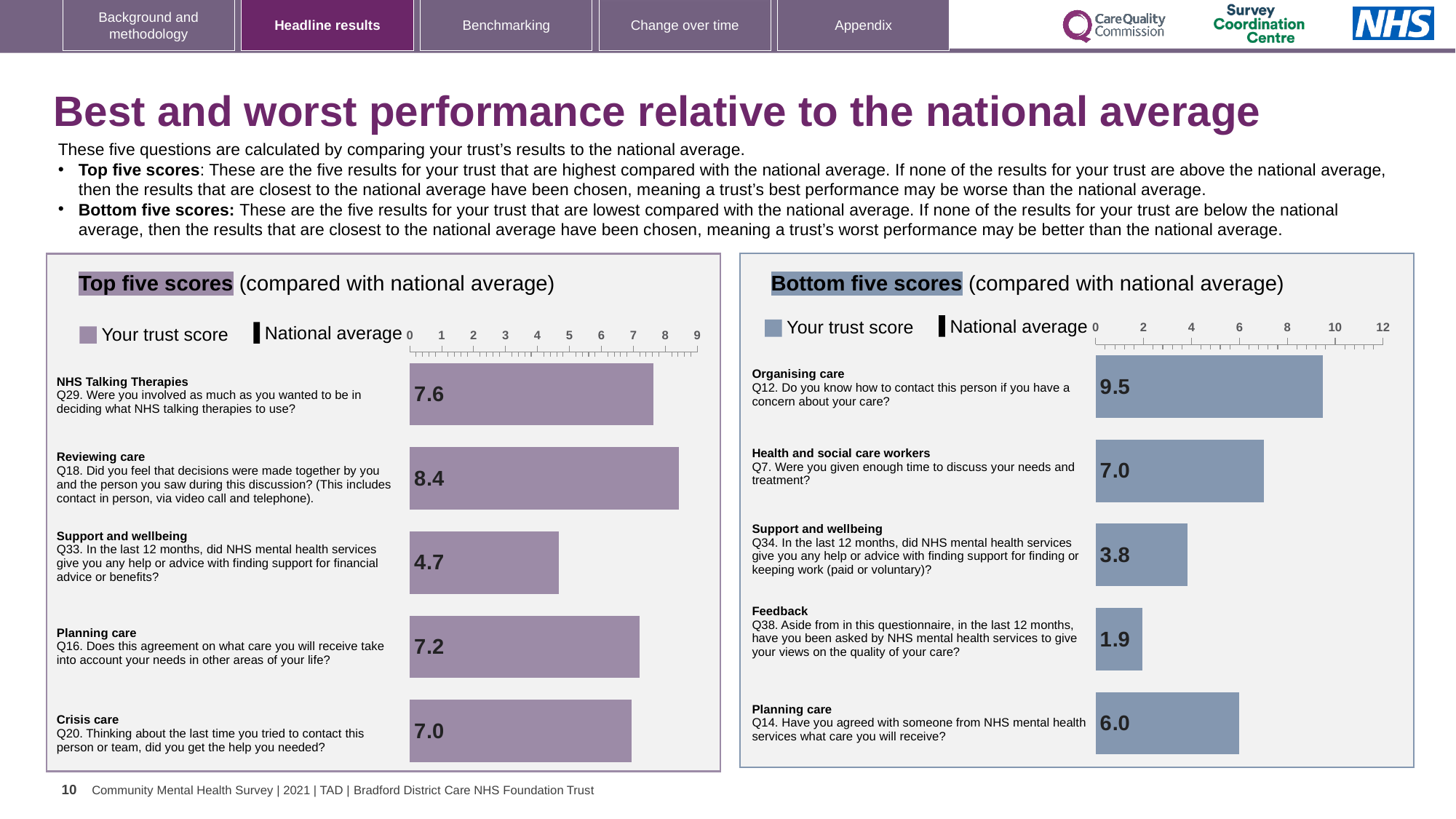
In the Bottom five scores chart, is the trust score for Q7 larger or smaller than the score for Q14? larger In the Bottom five scores chart, what is the trust score for Q38 (Feedback)? 1.9 In the Top five scores chart, how many questions are plotted? 5 In the Top five scores chart, which question has the lowest trust score? Q33 (Support and wellbeing) In the Bottom five scores chart, what is the trust score for Q12 (Organising care)? 9.5 In the Bottom five scores chart, which question has the lowest trust score? Q38 (Feedback) In the Top five scores chart, what is the trust score for Q18 (Reviewing care)? 8.4 In the Top five scores chart, what is the difference between the trust scores for Q18 and Q33? 3.7 In the Top five scores chart, what is the trust score for Q29 (NHS Talking Therapies)? 7.6 In the Top five scores chart, which question has the highest trust score? Q18 (Reviewing care) In the Bottom five scores chart, what is the difference between the trust scores for Q12 and Q34? 5.7 What type of chart is used in the Top five scores panel? Bar chart